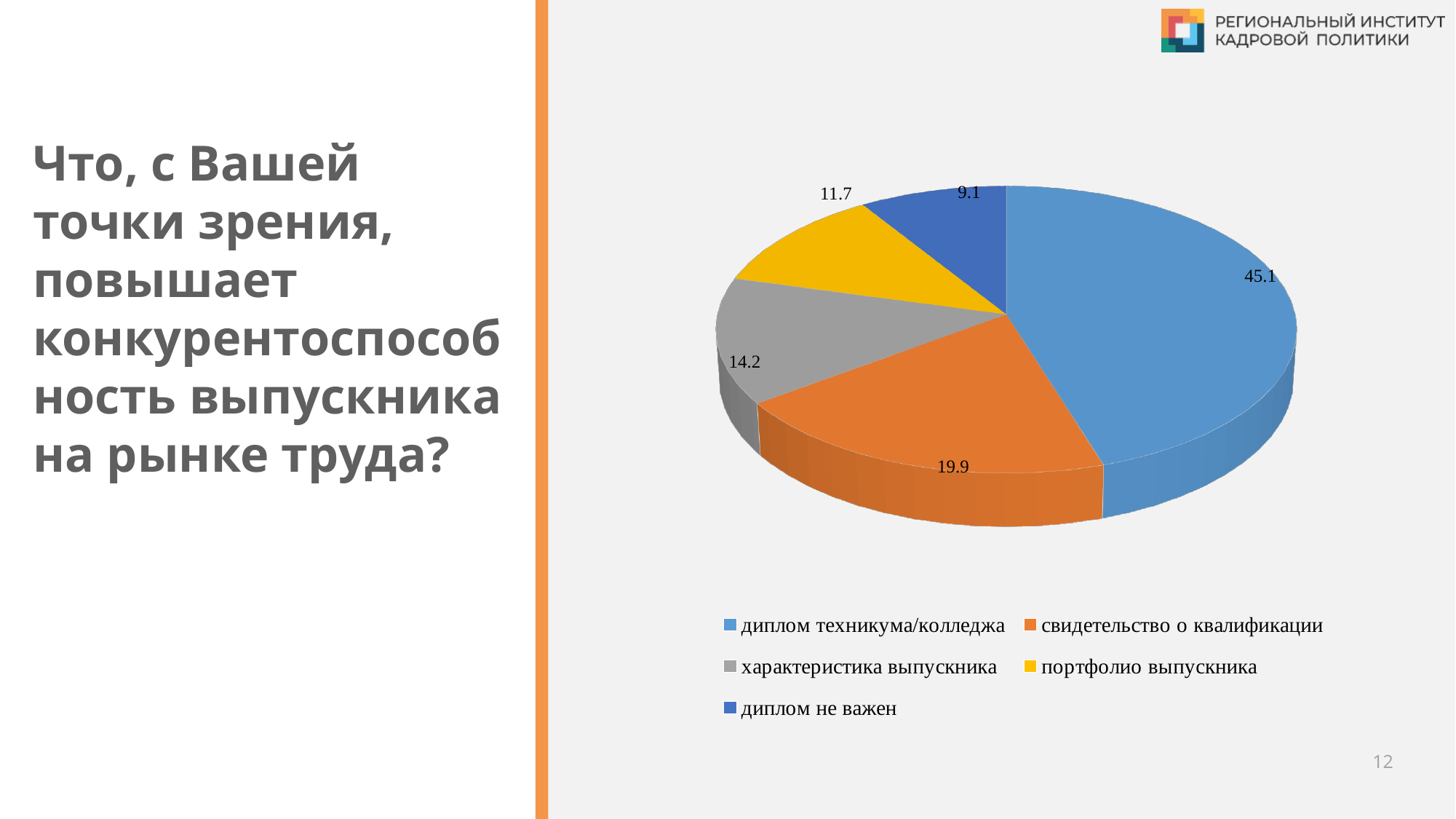
Which is larger: the value for "характеристика выпускника" or the value for "портфолио выпускника"? характеристика выпускника What is the value for "портфолио выпускника"? 11.7 What is the value for "свидетельство о квалификации"? 19.9 How many categories does the pie chart have? 5 What is the value for "характеристика выпускника"? 14.2 What is the difference between the values for "диплом техникума/колледжа" and "свидетельство о квалификации"? 25.2 Which colour represents "портфолио выпускника" in the pie chart? yellow What type of chart is shown on the slide? pie chart Which category has the largest slice of the pie? диплом техникума/колледжа What is the value for "диплом не важен"? 9.1 What is the value for "диплом техникума/колледжа"? 45.1 Which category has the smallest slice of the pie? диплом не важен